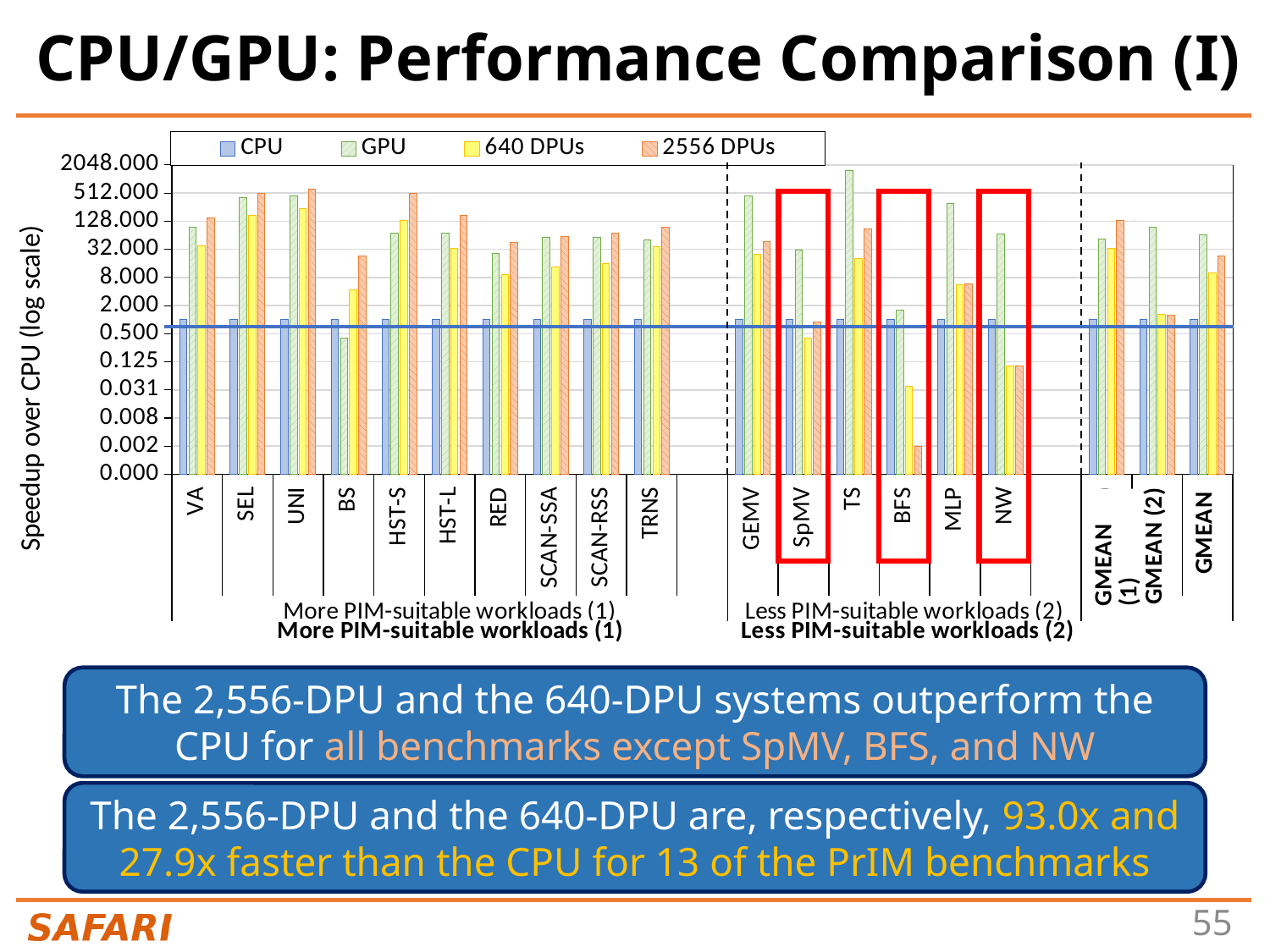
Which series has the tallest bar for the TS benchmark? GPU Is the GPU value for TS greater or less than 512.000? greater For the UNI benchmark, which is larger: the 640 DPUs value or the 2556 DPUs value? 2556 DPUs What is the label of the vertical axis? Speedup over CPU (log scale) Which benchmark has the highest GPU speedup? TS For the BS benchmark, which is larger: the GPU value or the 2556 DPUs value? 2556 DPUs What kind of chart is shown on the slide? bar chart Is the 640 DPUs value for NW greater or less than 0.500? less Is the 2556 DPUs value for SEL greater or less than 128.000? greater How many series does the chart legend list? 4